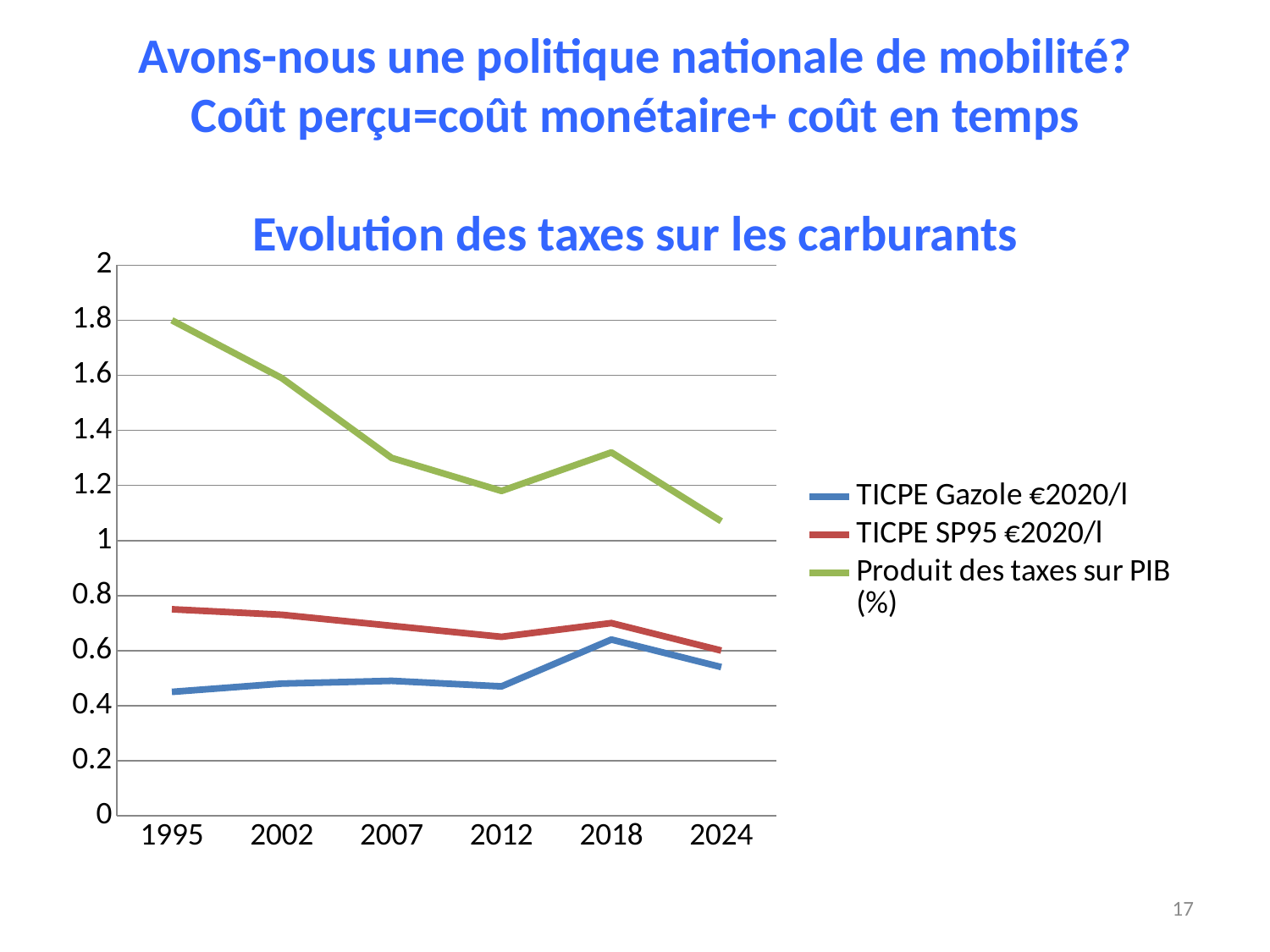
In which year is the value for Produit des taxes sur PIB (%) lowest? 2024 Is the value for Produit des taxes sur PIB (%) in 2024 greater or less than 1.2? less What is the title of the chart? Evolution des taxes sur les carburants In which year is the value for Produit des taxes sur PIB (%) highest? 1995 Does the value for Produit des taxes sur PIB (%) rise or fall overall from 1995 to 2024? fall In which year is the value for TICPE Gazole €2020/l highest? 2018 Which series is drawn in green? Produit des taxes sur PIB (%) How many years are shown on the x axis? 6 What kind of chart is shown on the slide? line chart In 2024, which is larger: TICPE SP95 €2020/l or TICPE Gazole €2020/l? TICPE SP95 €2020/l How many series does the legend list? 3 Is the value for Produit des taxes sur PIB (%) in 1995 greater or less than 1.6? greater